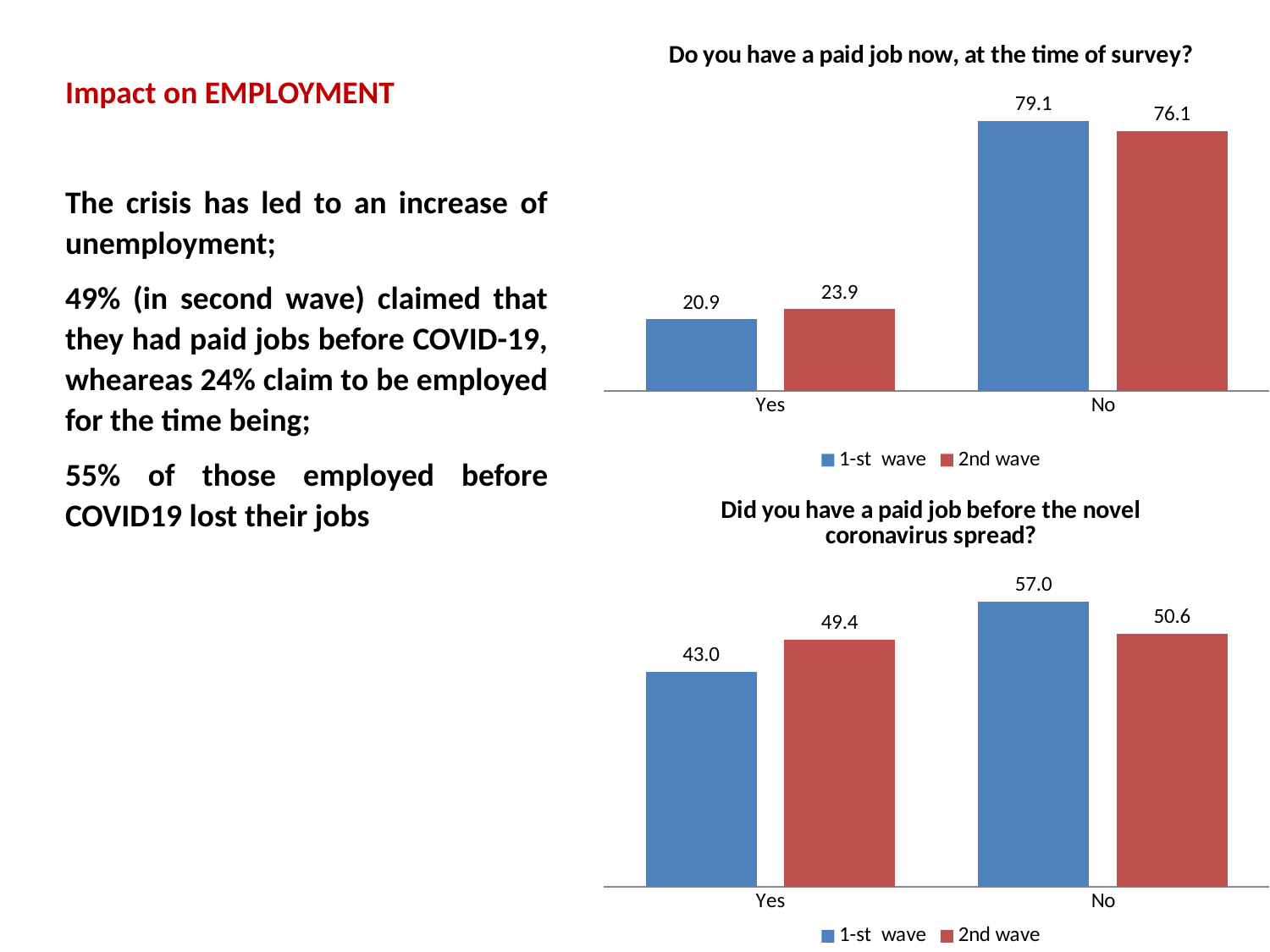
In the chart titled "Did you have a paid job before the novel coronavirus spread?", what colour are the 2nd wave bars? Red In the chart titled "Do you have a paid job now, at the time of survey?", what is the difference between the 1-st wave and 2nd wave values for Yes? 3.0 In the chart titled "Did you have a paid job before the novel coronavirus spread?", what is the difference between the 1-st wave and 2nd wave values for No? 6.4 In the chart titled "Do you have a paid job now, at the time of survey?", how many series does the legend list? 2 In the chart titled "Do you have a paid job now, at the time of survey?", what is the value for Yes in the 1-st wave? 20.9 In the chart titled "Did you have a paid job before the novel coronavirus spread?", what is the value for No in the 1-st wave? 57.0 In the chart titled "Did you have a paid job before the novel coronavirus spread?", how many categories are shown on the x axis? 2 In the chart titled "Did you have a paid job before the novel coronavirus spread?", what is the value for Yes in the 2nd wave? 49.4 In the chart titled "Do you have a paid job now, at the time of survey?", what is the value for No in the 2nd wave? 76.1 In the chart titled "Do you have a paid job now, at the time of survey?", which category has the highest value in the 1-st wave? No In the chart titled "Did you have a paid job before the novel coronavirus spread?", which is larger for Yes: the 1-st wave or the 2nd wave? 2nd wave What kind of chart is the chart titled "Do you have a paid job now, at the time of survey?"? Bar chart